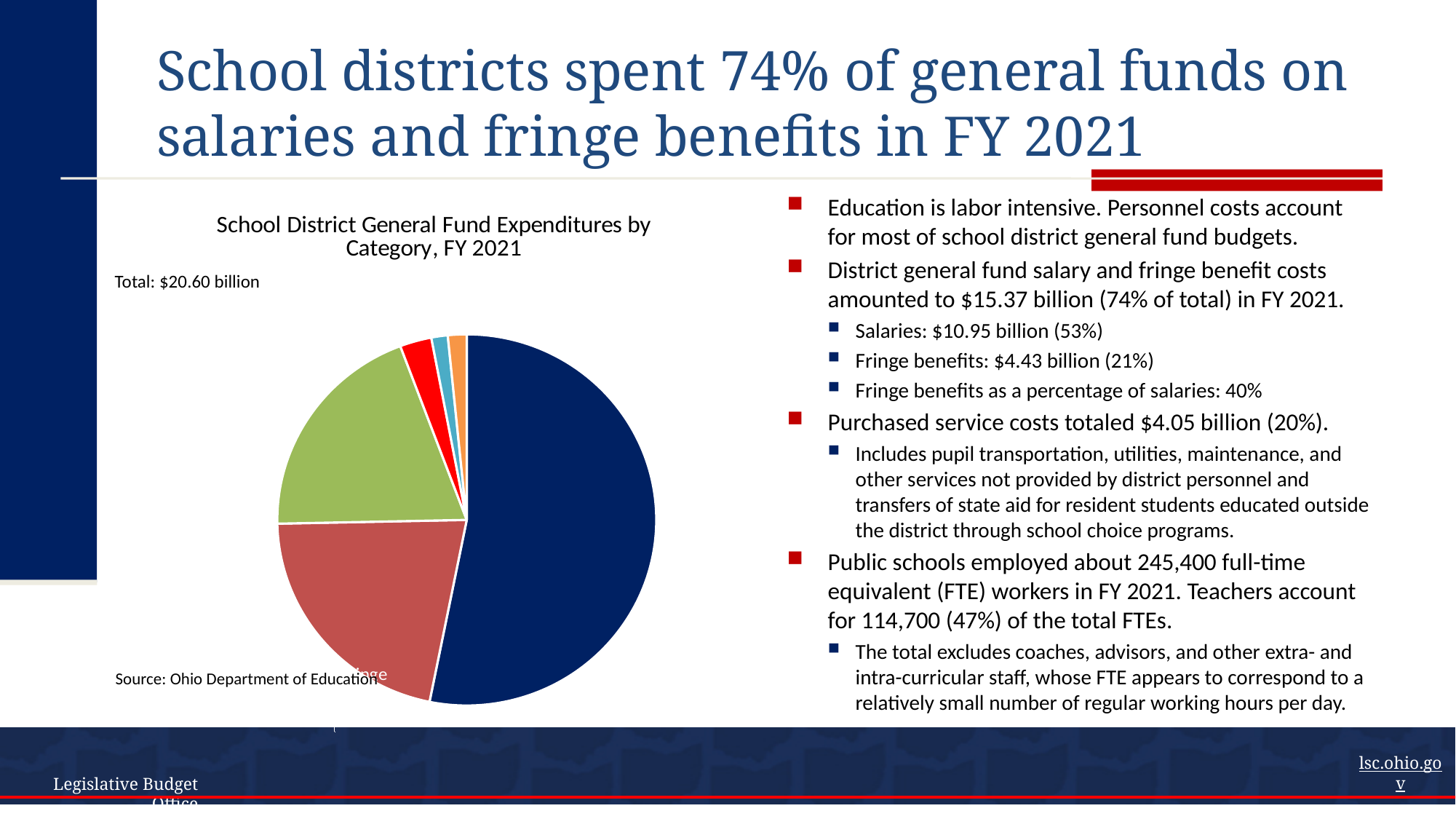
How many slices does the pie chart have? 6 Is the largest slice of the pie chart more or less than half of the pie? more What total amount is printed above the pie chart? $20.60 billion What kind of chart is shown on the slide? pie chart What colour is the largest slice of the pie chart? dark blue What is the title of the pie chart? School District General Fund Expenditures by Category, FY 2021